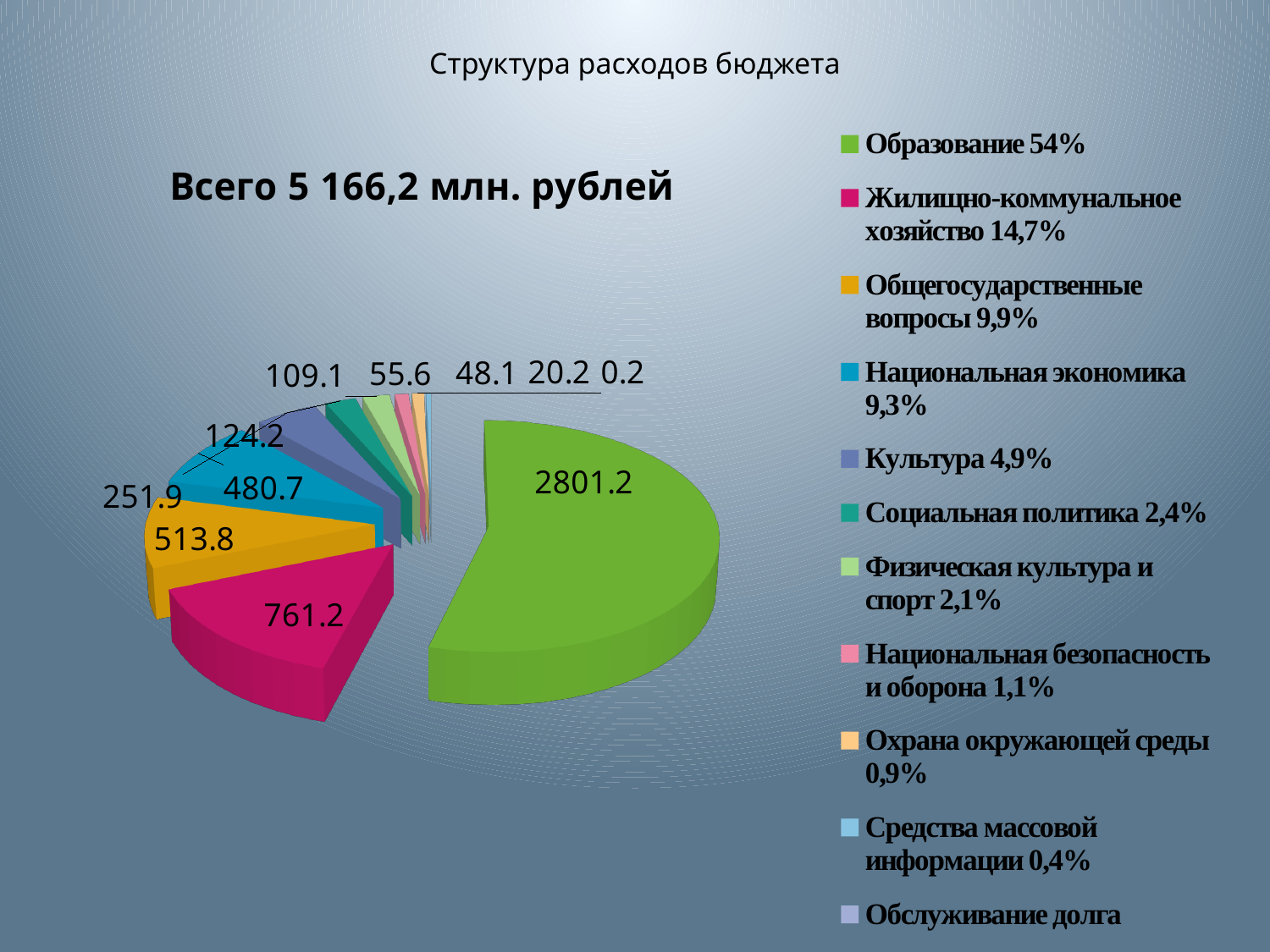
What total amount is stated above the pie chart? 5 166,2 млн. рублей What is the value shown for Образование? 2801.2 What is the value shown for Общегосударственные вопросы? 513.8 How many categories does the pie chart have? 11 What kind of chart is shown on the slide? pie chart What is the value shown for Жилищно-коммунальное хозяйство? 761.2 What share of the pie does Образование represent, according to the legend? 54% What is the value shown for Национальная экономика? 480.7 Which category has the largest slice of the pie? Образование Which is larger, the value for Общегосударственные вопросы or the value for Национальная экономика? Общегосударственные вопросы What is the difference between the values for Образование and Жилищно-коммунальное хозяйство? 2040 Which category has the smallest slice of the pie? Обслуживание долга